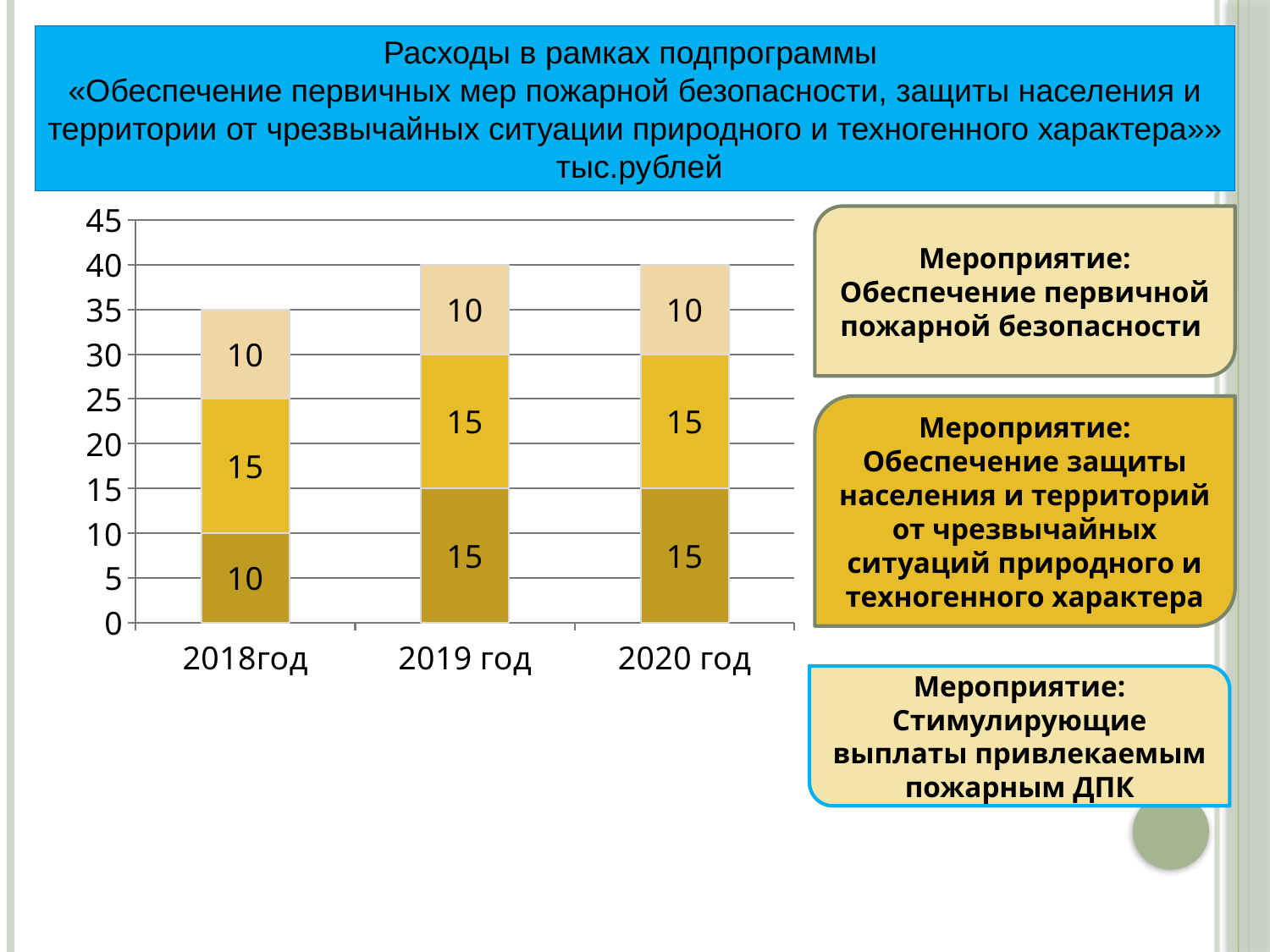
What is the total height of the stacked bar for 2018год? 35 How many year categories are shown on the x axis of the chart? 3 What is the value of the top (light beige) segment of the bar for 2020 год? 10 Does the total of the stacked bar for 2018год rise or fall compared with 2019 год? rise What is the value of the bottom (dark gold) segment of the bar for 2018год? 10 Which year has the lowest total stacked bar? 2018год What is the total height of the stacked bar for 2019 год? 40 Which is larger: the bottom segment of the 2020 год bar or the top segment of the 2020 год bar? the bottom segment What is the difference between the bottom segment value for 2019 год and the bottom segment value for 2018год? 5 What is the value of the middle (yellow) segment of the bar for 2019 год? 15 What kind of chart is shown on the slide? stacked bar chart What unit of measurement is stated in the chart title? тыс.рублей